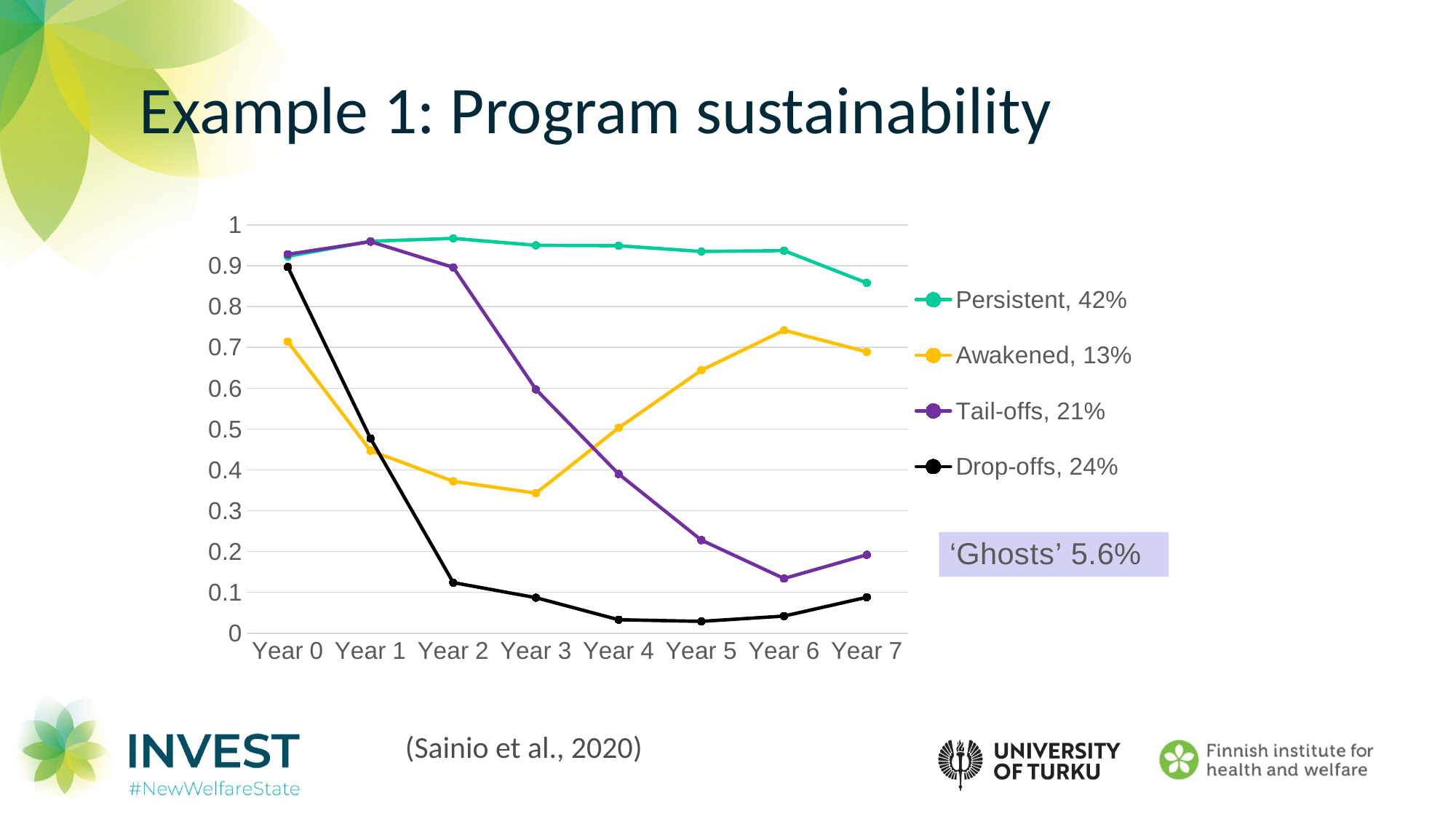
Is the value for Drop-offs at Year 4 greater or less than 0.1? less How many series does the legend list? 4 Which series has the highest value at Year 7? Persistent What kind of chart is shown on the slide? line chart What percentage is shown next to Persistent in the legend? 42% Is the value for Tail-offs at Year 3 greater or less than 0.5? greater Is the value for Persistent at Year 2 greater or less than 0.9? greater Which series has the lowest value at Year 2? Drop-offs How many year points are plotted along the x axis? 8 At Year 5, which is larger: Awakened or Tail-offs? Awakened Do the Drop-offs values rise or fall from Year 0 to Year 4? fall